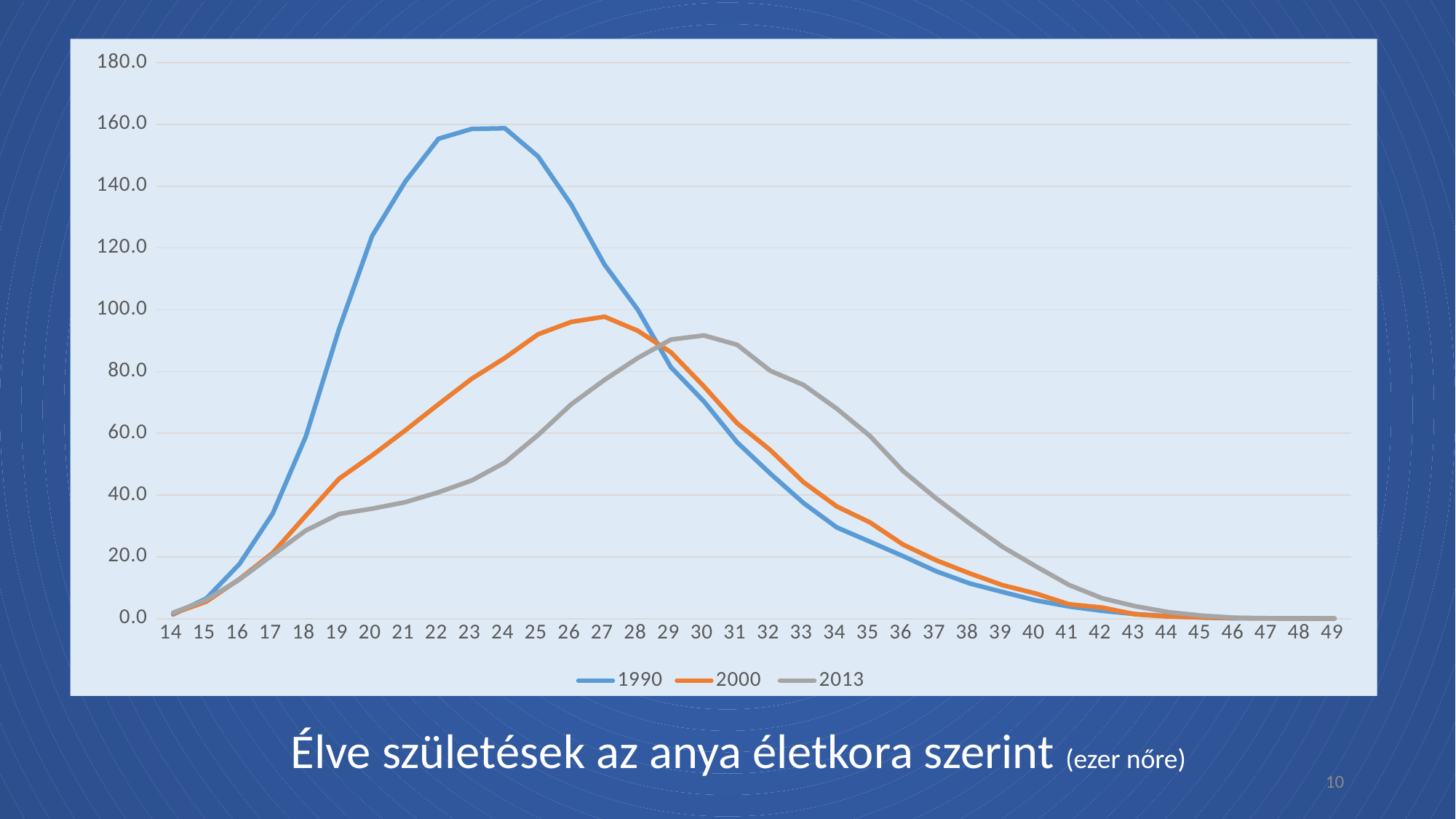
At age 20, which series has the higher value, 2000 or 2013? 2000 Do the values of the 1990 series rise or fall from age 30 to age 49? fall Which years are listed in the legend? 1990, 2000, 2013 At which age does the 2000 series reach its highest value? 27 How many series does the legend list? 3 At age 35, which series has the higher value, 1990 or 2013? 2013 Which series reaches the highest peak value overall? 1990 Is the value for the 2013 series at age 20 greater or less than 40? less Is the value for the 2000 series at age 27 greater or less than 100? less How many age categories are shown on the x axis? 36 Is the value for the 1990 series at age 24 greater or less than 140? greater What kind of chart is shown on the slide? line chart